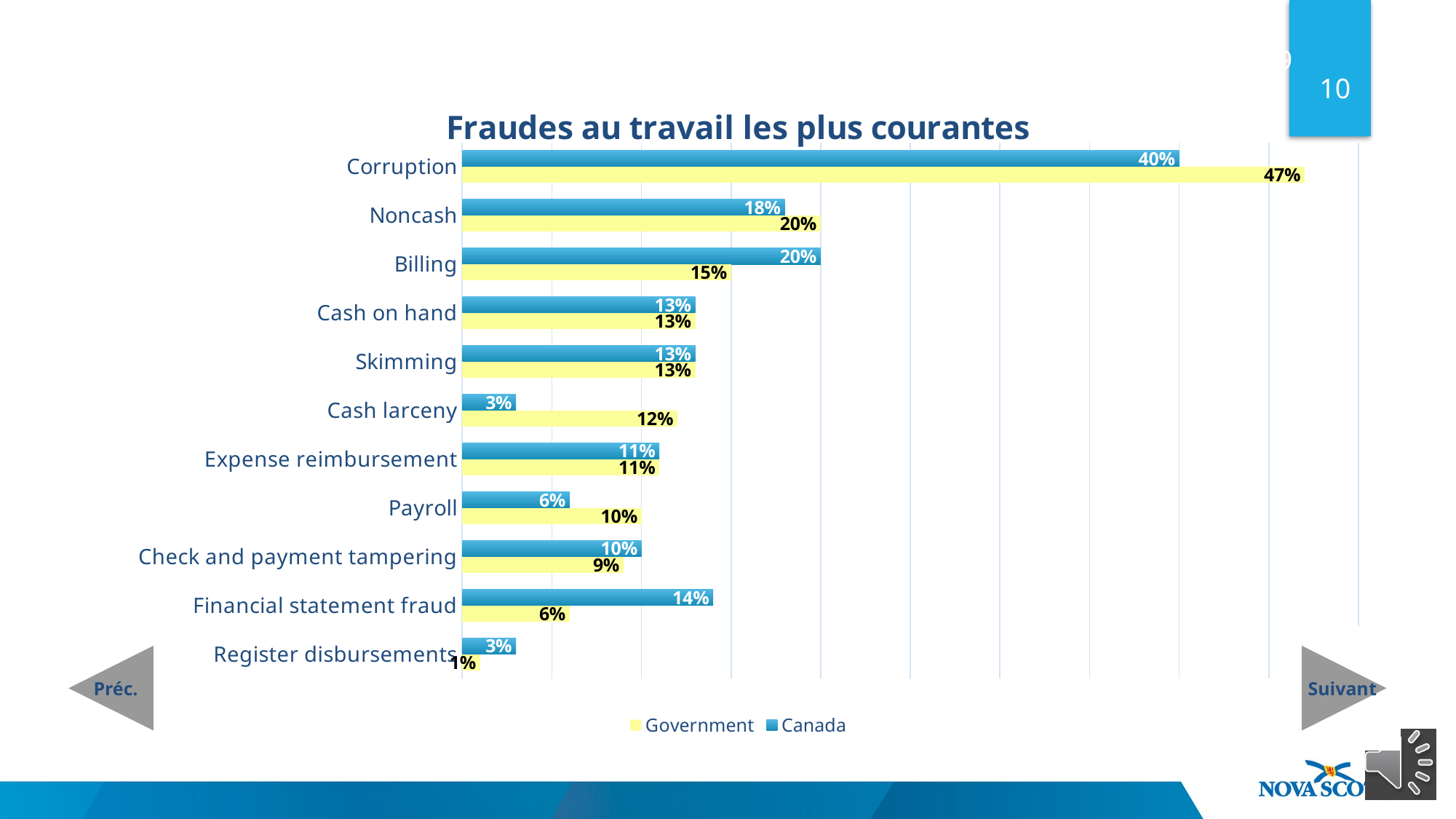
What is the Government value for Cash larceny? 12% For Billing, which series has the larger value, Government or Canada? Canada How many categories are shown on the chart? 11 What is the difference between the Government and Canada values for Cash larceny? 9% For Payroll, which series has the larger value, Government or Canada? Government Which category has the highest Canada value? Corruption How many series does the legend list? 2 Which category has the lowest Government value? Register disbursements What is the Government value for Corruption? 47% What type of chart is shown on the slide? Bar chart What is the difference between the Government and Canada values for Corruption? 7% What is the Canada value for Financial statement fraud? 14%